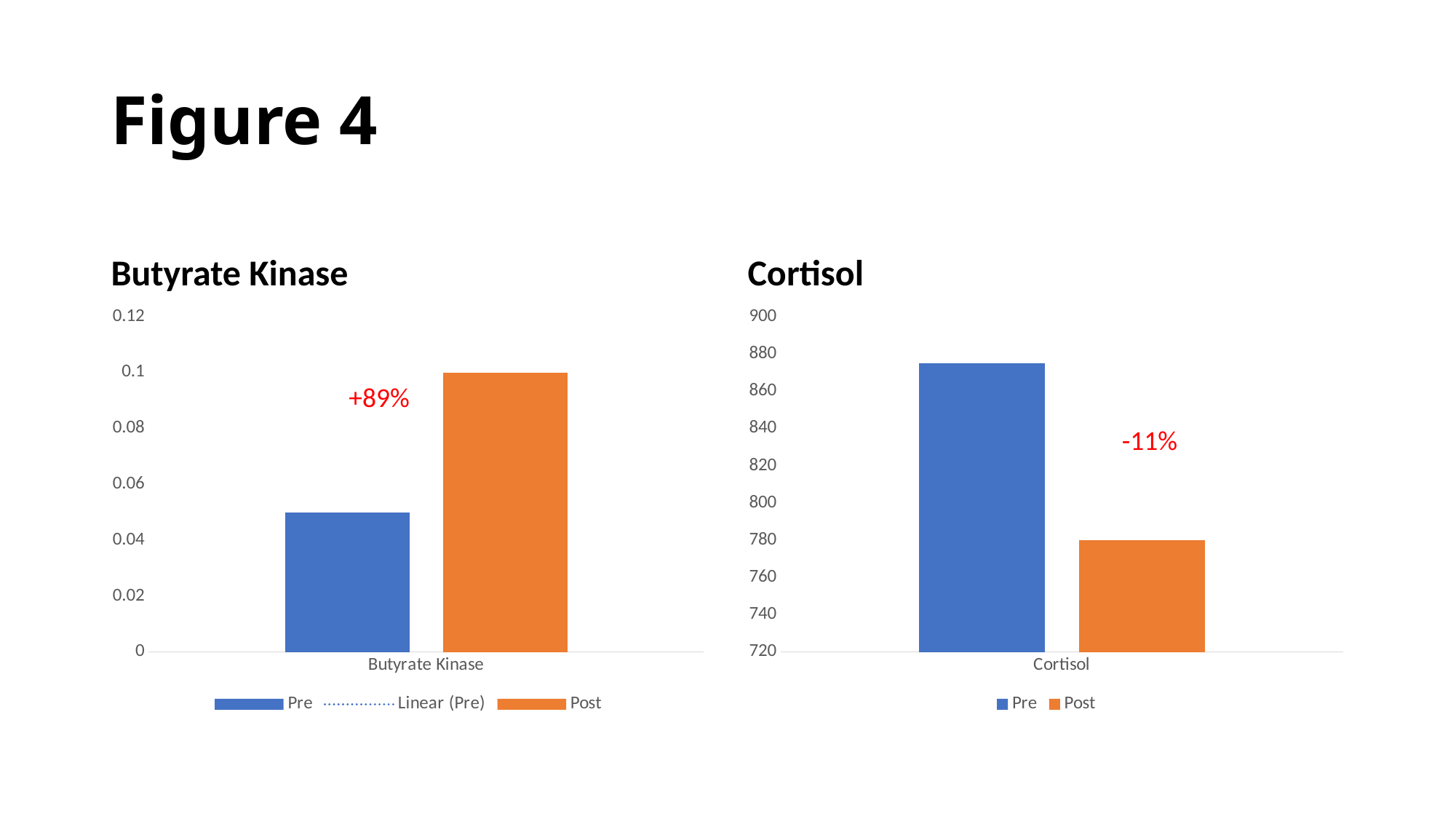
In the Cortisol chart, is the Post value greater or less than 800? less How many entries does the legend of the Butyrate Kinase chart list? 3 In the Butyrate Kinase chart, is the Post value greater or less than 0.08? greater What percentage change is annotated in red on the Butyrate Kinase chart? +89% In the Butyrate Kinase chart, which is larger, the Pre value or the Post value? Post How many entries does the legend of the Cortisol chart list? 2 In the Cortisol chart, is the Pre value greater or less than 860? greater In the Butyrate Kinase chart, what kind of chart is shown? bar chart In the Cortisol chart, what kind of chart is shown? bar chart What percentage change is annotated in red on the Cortisol chart? -11% In the Cortisol chart, which is larger, the Pre value or the Post value? Pre